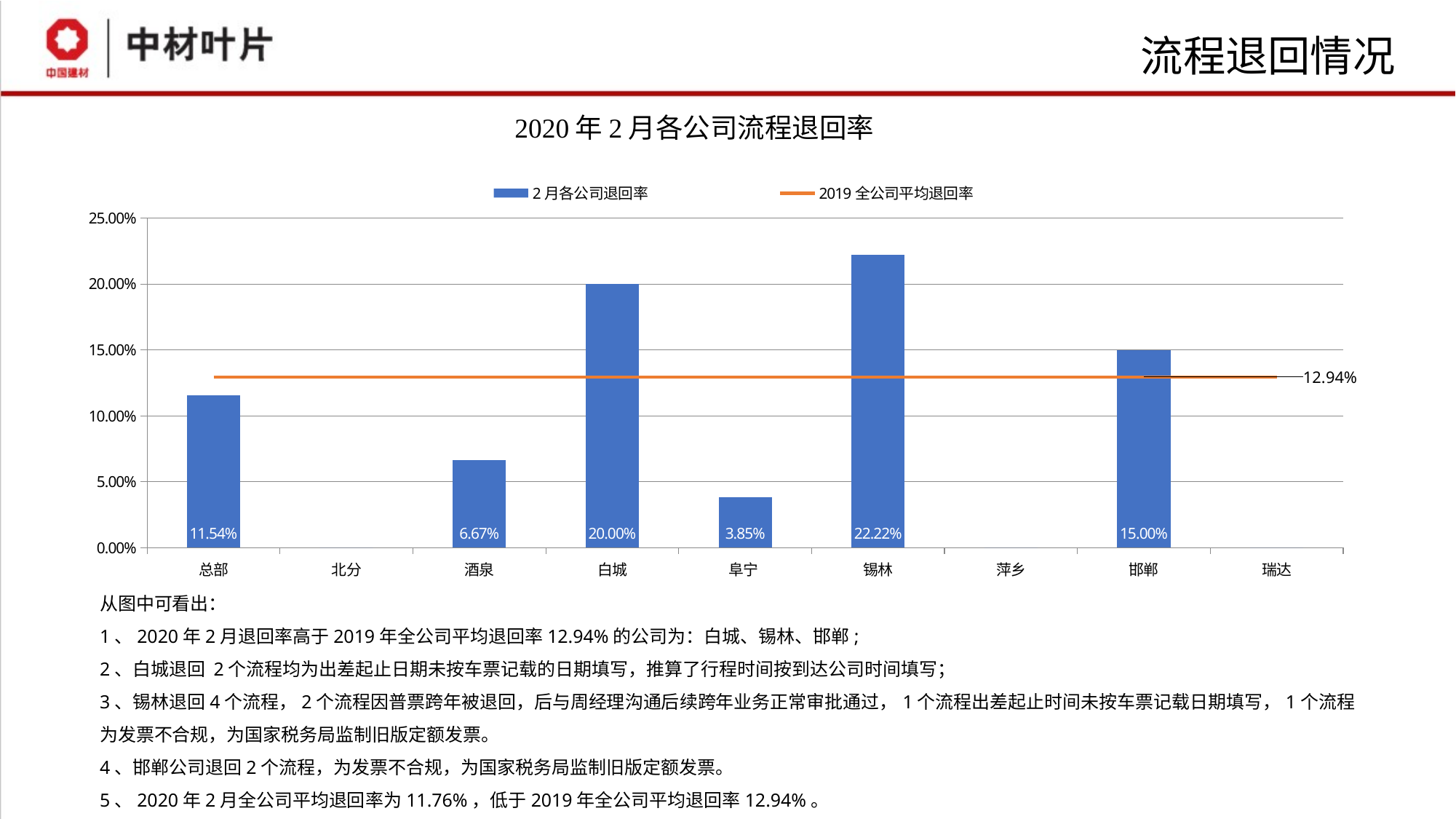
What is the difference between the February return rates of 锡林 and 白城? 2.22% How many companies are listed on the x axis? 9 How many series does the legend list? 2 Among the companies with a labelled bar, which has the lowest February return rate? 阜宁 Which has a higher February return rate, 总部 or 酒泉? 总部 What kind of chart is shown on the slide? combination bar and line chart What is the February return rate for 锡林? 22.22% Is the value for 白城 greater or less than 15.00%? greater Which company has the highest February return rate? 锡林 What is the February return rate for 阜宁? 3.85% What value does the 2019 全公司平均退回率 line show? 12.94% What is the February return rate for 邯郸? 15.00%